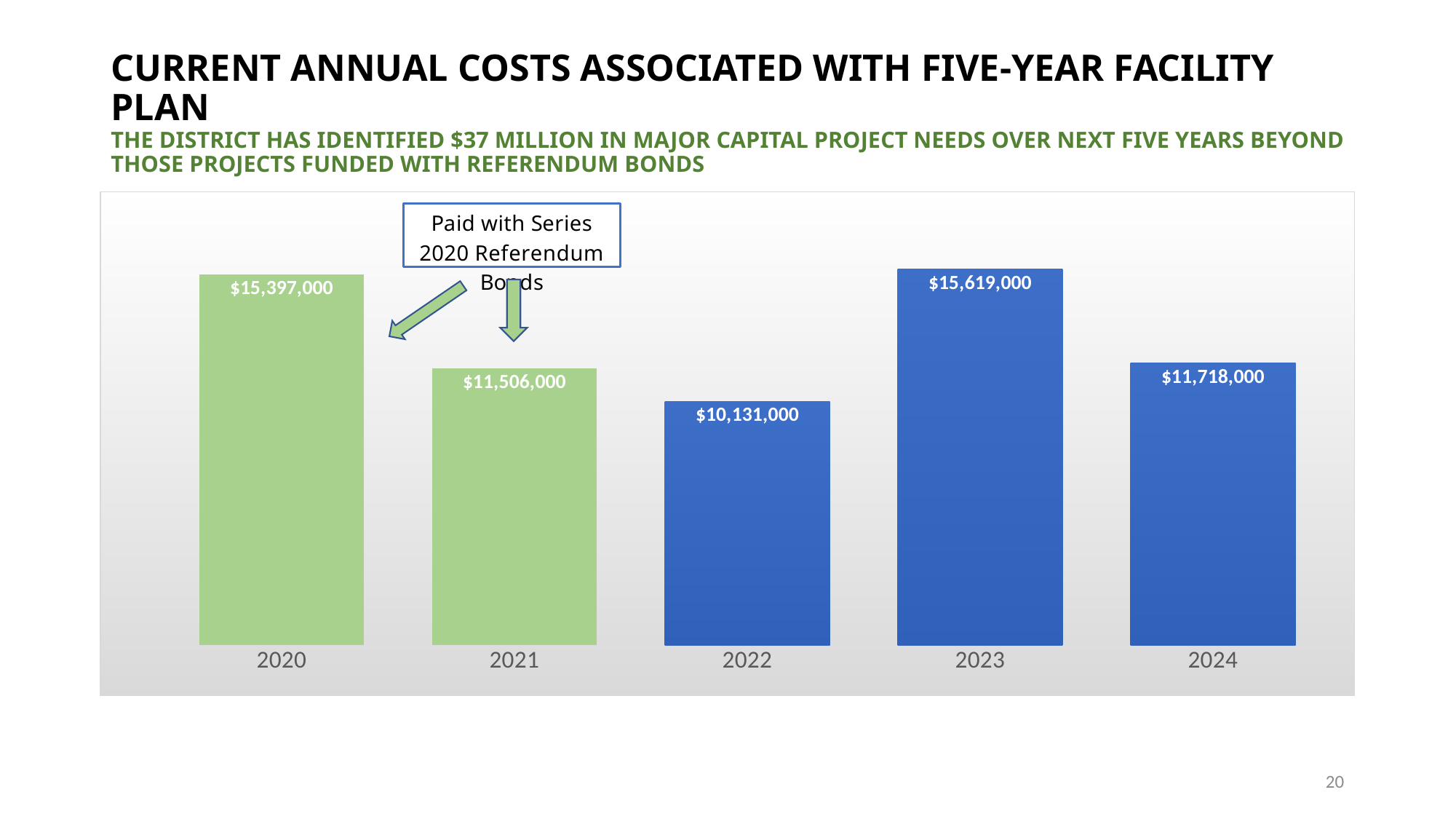
Which year has the highest value? 2023 Which years are marked as paid with Series 2020 Referendum Bonds? 2020 and 2021 Which year has the lowest value? 2022 What is the value for 2022? $10,131,000 What is the value for 2024? $11,718,000 What is the difference between the values for 2021 and 2022? $1,375,000 What is the difference between the values for 2023 and 2020? $222,000 What is the value for 2020? $15,397,000 Which is larger, the value for 2021 or the value for 2024? 2024 How many years are shown on the chart? 5 What kind of chart is shown on the slide? Bar chart Do the values rise or fall from 2020 to 2022? Fall